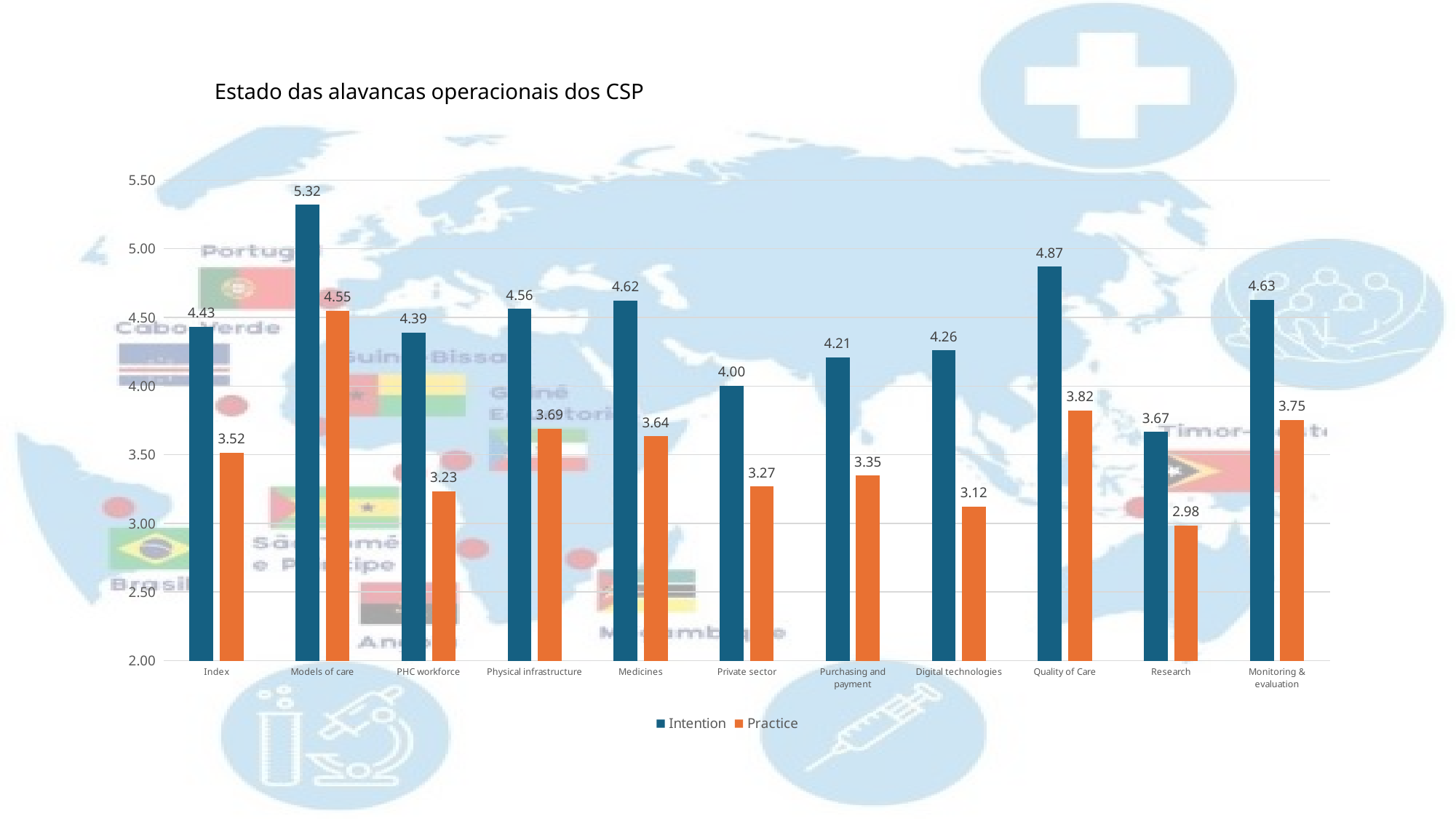
What is the title of the chart? Estado das alavancas operacionais dos CSP Is the Intention value for Research greater or less than 4.00? less Which is larger: the Practice value for Medicines or the Practice value for Physical infrastructure? Physical infrastructure Which category has the lowest Practice value? Research What is the Intention value for Models of care? 5.32 Which category has the highest Intention value? Models of care What kind of chart is shown on the slide? Bar chart How many categories are shown on the x axis? 11 How many series does the legend list? 2 What is the difference between the Intention and Practice values for Quality of Care? 1.05 What is the Practice value for Research? 2.98 What is the Practice value for Digital technologies? 3.12